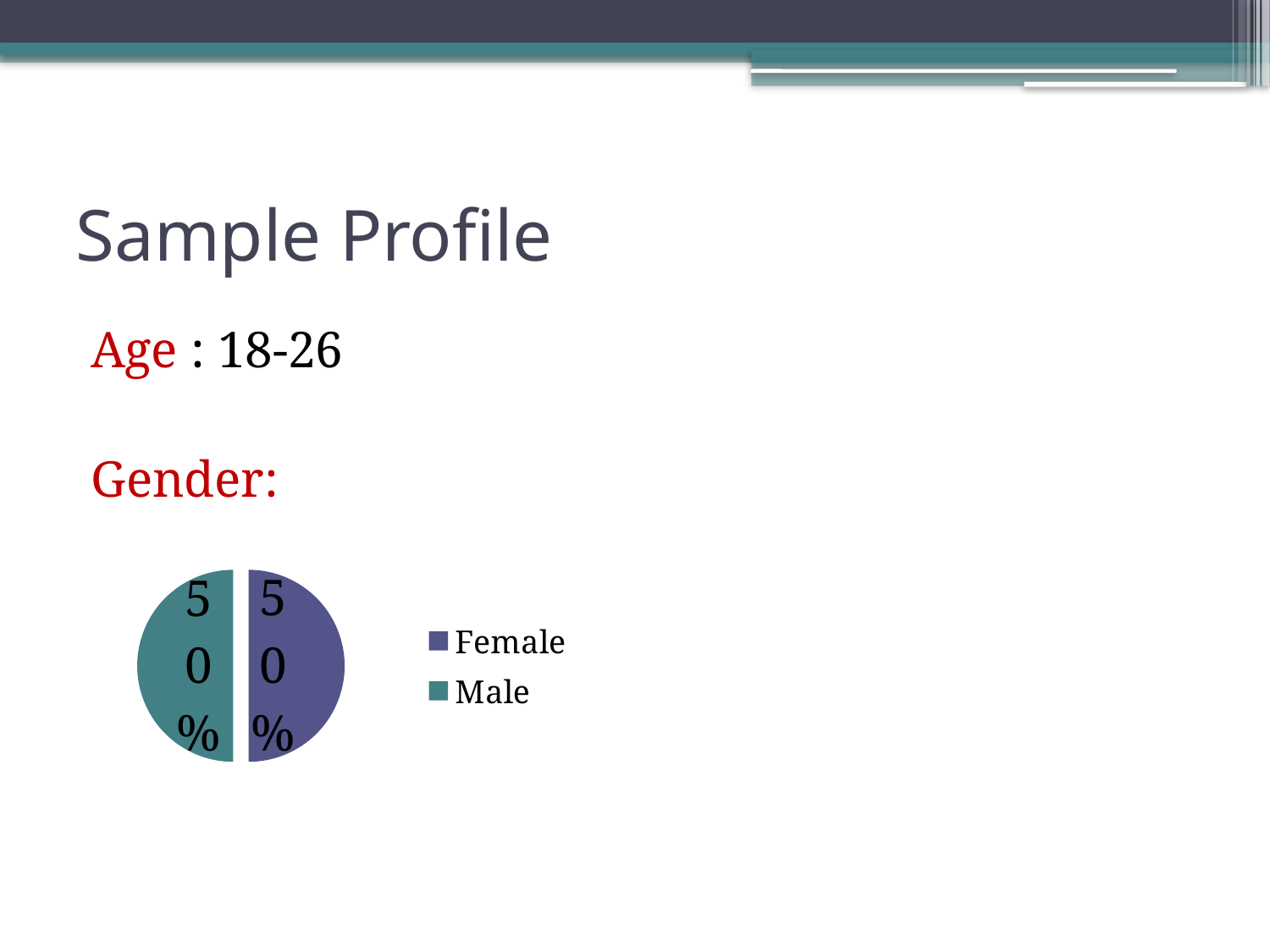
Which legend entry is shown in teal? Male What is the value shown for Female? 50% What kind of chart is shown on the slide? pie chart How many slices does the pie chart have? 2 Which legend entry is shown in purple? Female What is the value shown for Male? 50% How many entries does the legend list? 2 What share of the pie does the Female slice represent? 50% What share of the pie does the Male slice represent? 50% What is the difference between the Female and Male values? 0%